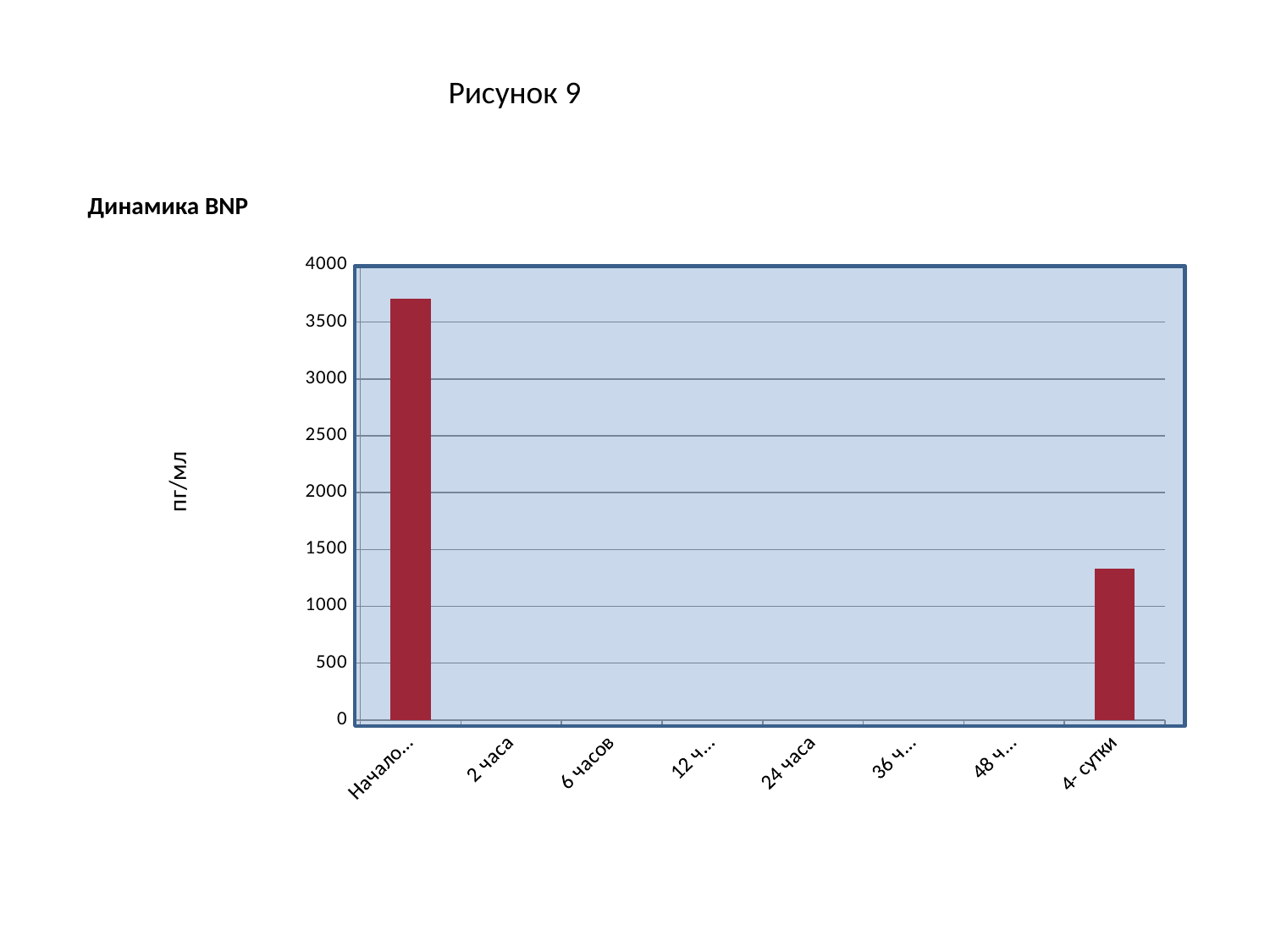
Which category has the highest value in the chart? Начало... Is the value for the first category (Начало...) greater or less than 4000? less What is the title of the chart? Динамика BNP What is the maximum value shown on the vertical axis of the chart? 4000 Is the value for 4- сутки greater or less than 1500? less Is the value for the first category (Начало...) greater or less than 3500? greater How many categories are shown along the x axis of the chart? 8 Which is larger, the value for the first category (Начало...) or the value for 4- сутки? Начало... Does the value fall or rise from the first category (Начало...) to 4- сутки? fall What unit is shown on the vertical axis of the chart? пг/мл What kind of chart is shown on the slide? bar chart